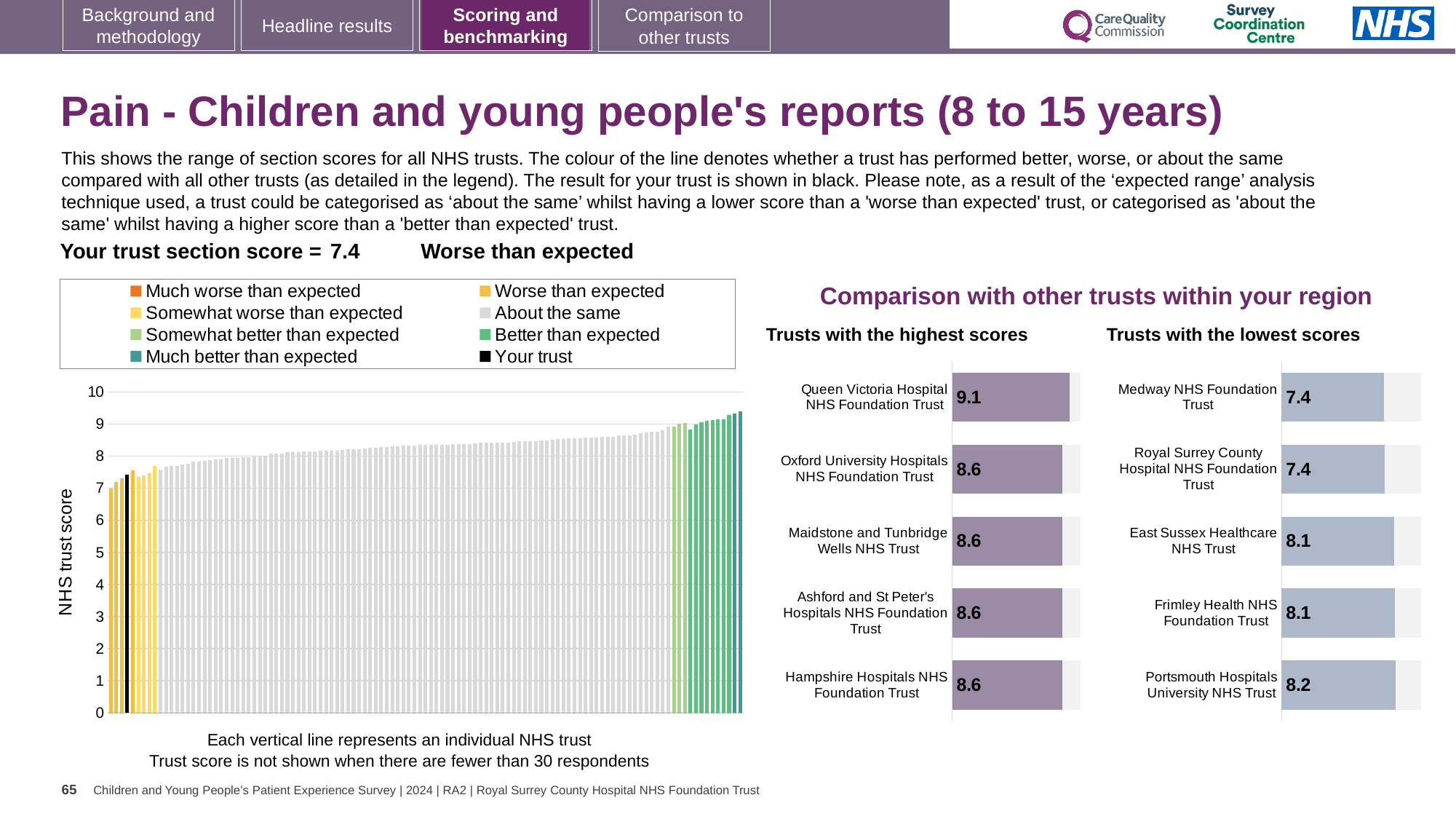
In the 'Trusts with the lowest scores' chart, what is the score for Medway NHS Foundation Trust? 7.4 In the 'Trusts with the lowest scores' chart, what is the difference between the scores of Portsmouth Hospitals University NHS Trust and Royal Surrey County Hospital NHS Foundation Trust? 0.8 How many entries does the legend above the large chart on the left list? 8 In the 'Trusts with the lowest scores' chart, which has the larger score: East Sussex Healthcare NHS Trust or Medway NHS Foundation Trust? East Sussex Healthcare NHS Trust How many trusts are listed in the 'Trusts with the highest scores' chart? 5 In the large chart on the left, do the trust scores rise or fall from left to right? Rise In the 'Trusts with the lowest scores' chart, what is the score for Portsmouth Hospitals University NHS Trust? 8.2 What kind of chart is the large chart on the left showing NHS trust scores? Bar chart In the 'Trusts with the lowest scores' chart, which trust has the highest score? Portsmouth Hospitals University NHS Trust In the 'Trusts with the highest scores' chart, what is the difference between the scores of Queen Victoria Hospital NHS Foundation Trust and Oxford University Hospitals NHS Foundation Trust? 0.5 In the 'Trusts with the highest scores' chart, which trust has the highest score? Queen Victoria Hospital NHS Foundation Trust In the 'Trusts with the highest scores' chart, what is the score for Queen Victoria Hospital NHS Foundation Trust? 9.1